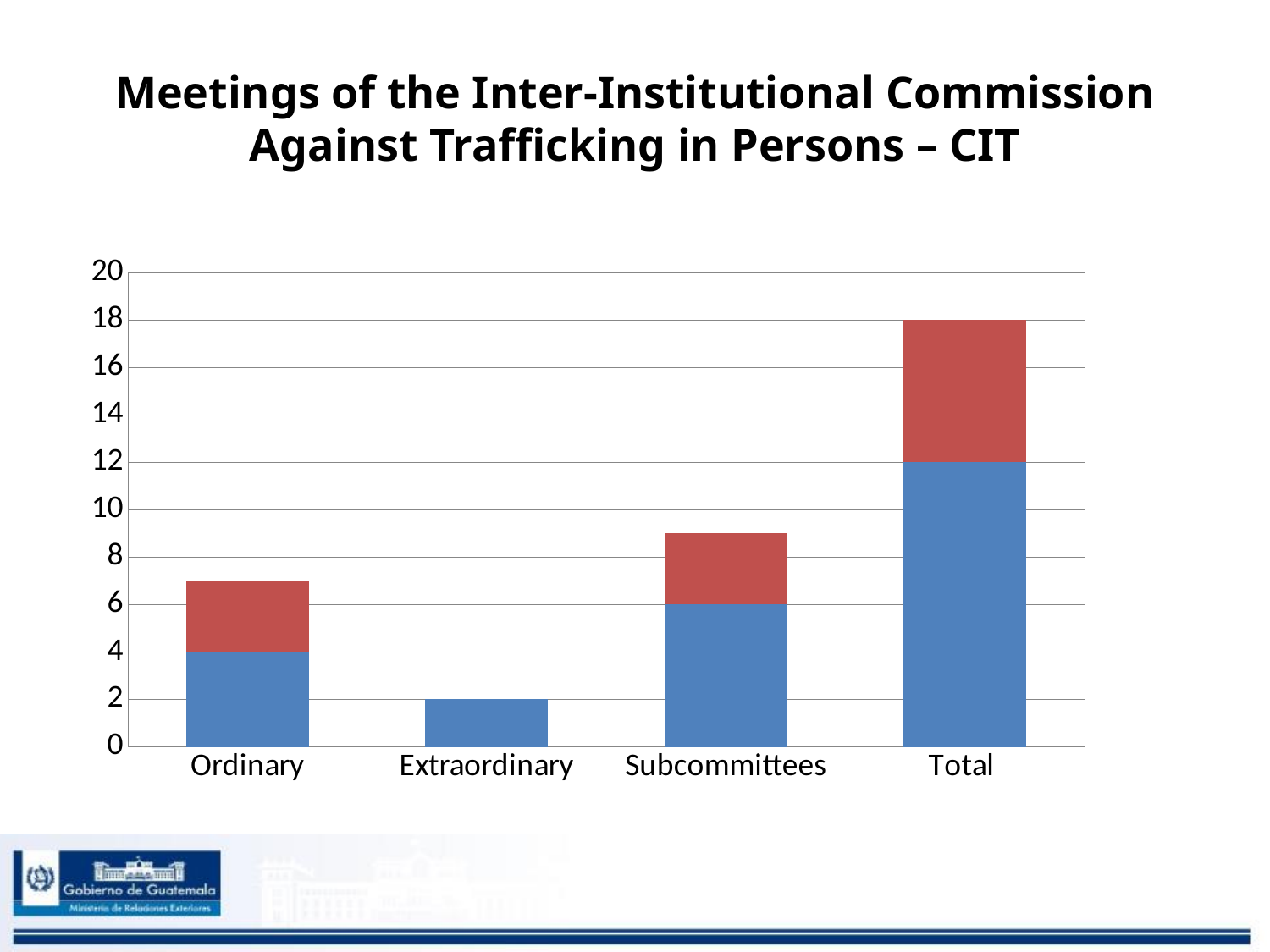
How many categories are shown on the x axis of the chart? 4 What is the value of the blue segment for Ordinary? 4 What kind of chart is shown on the slide? bar chart What is the difference between the blue segment for Total and the blue segment for Ordinary? 8 Which category has the shortest bar? Extraordinary What is the value of the blue segment for Extraordinary? 2 Is the total height of the Subcommittees bar greater or less than 10? less Which category has the tallest stacked bar? Total What is the total height of the stacked bar for Total? 18 What is the value of the blue segment for Total? 12 Is the total height of the Ordinary bar greater or less than 6? greater What is the value of the blue segment for Subcommittees? 6